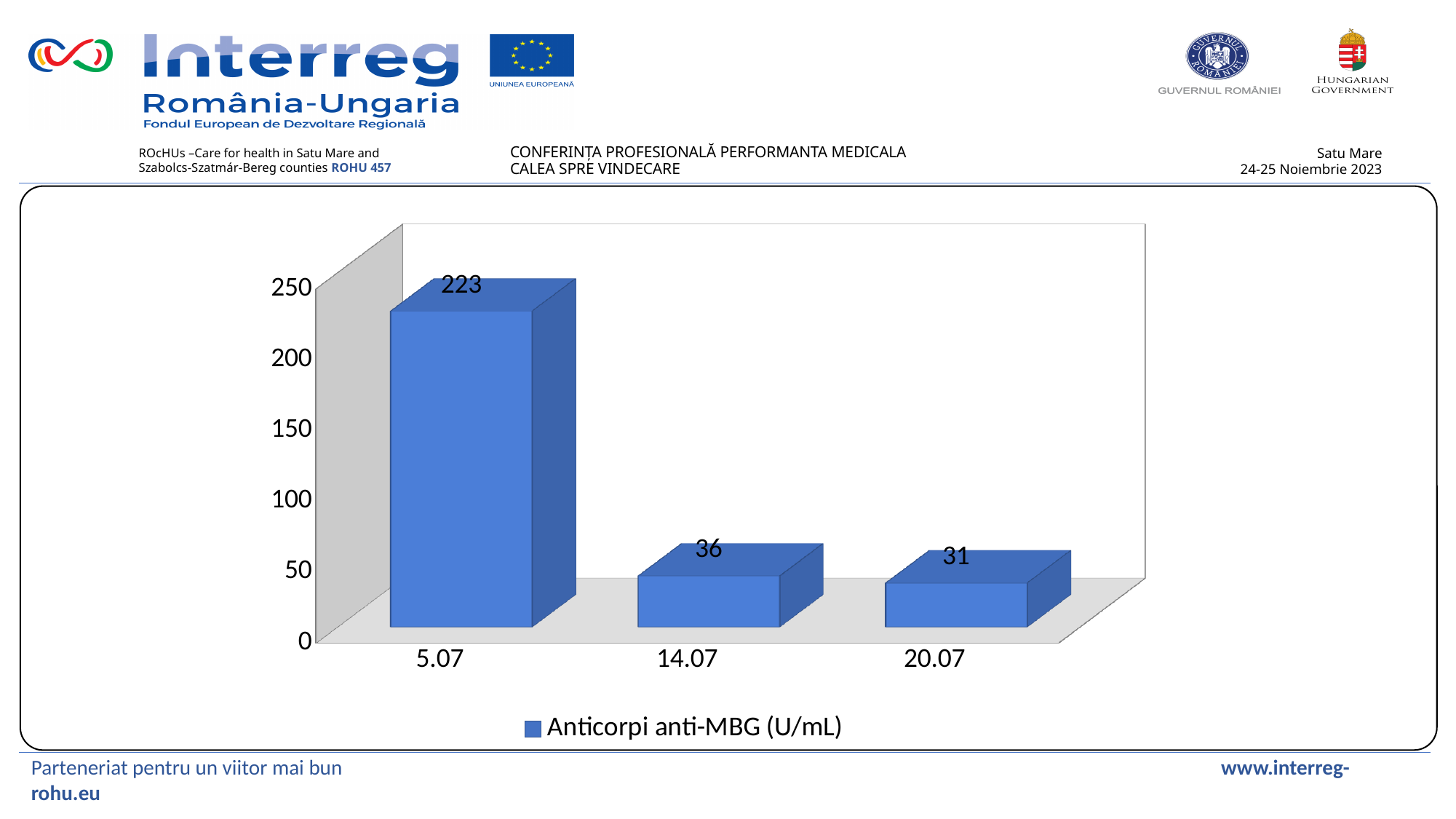
What is the value of Anticorpi anti-MBG (U/mL) for 5.07? 223 What kind of chart is shown on the slide? bar chart What is the value of Anticorpi anti-MBG (U/mL) for 20.07? 31 Which category has the highest value of Anticorpi anti-MBG (U/mL)? 5.07 Is the value for 5.07 greater or less than 200? greater What is the difference between the values for 5.07 and 14.07? 187 Which category has the lowest value of Anticorpi anti-MBG (U/mL)? 20.07 Which is larger, the value for 5.07 or the value for 20.07? 5.07 How many categories are shown on the x axis? 3 Do the values rise or fall from 5.07 to 20.07 along the x axis? fall What is the value of Anticorpi anti-MBG (U/mL) for 14.07? 36 What is the difference between the values for 14.07 and 20.07? 5